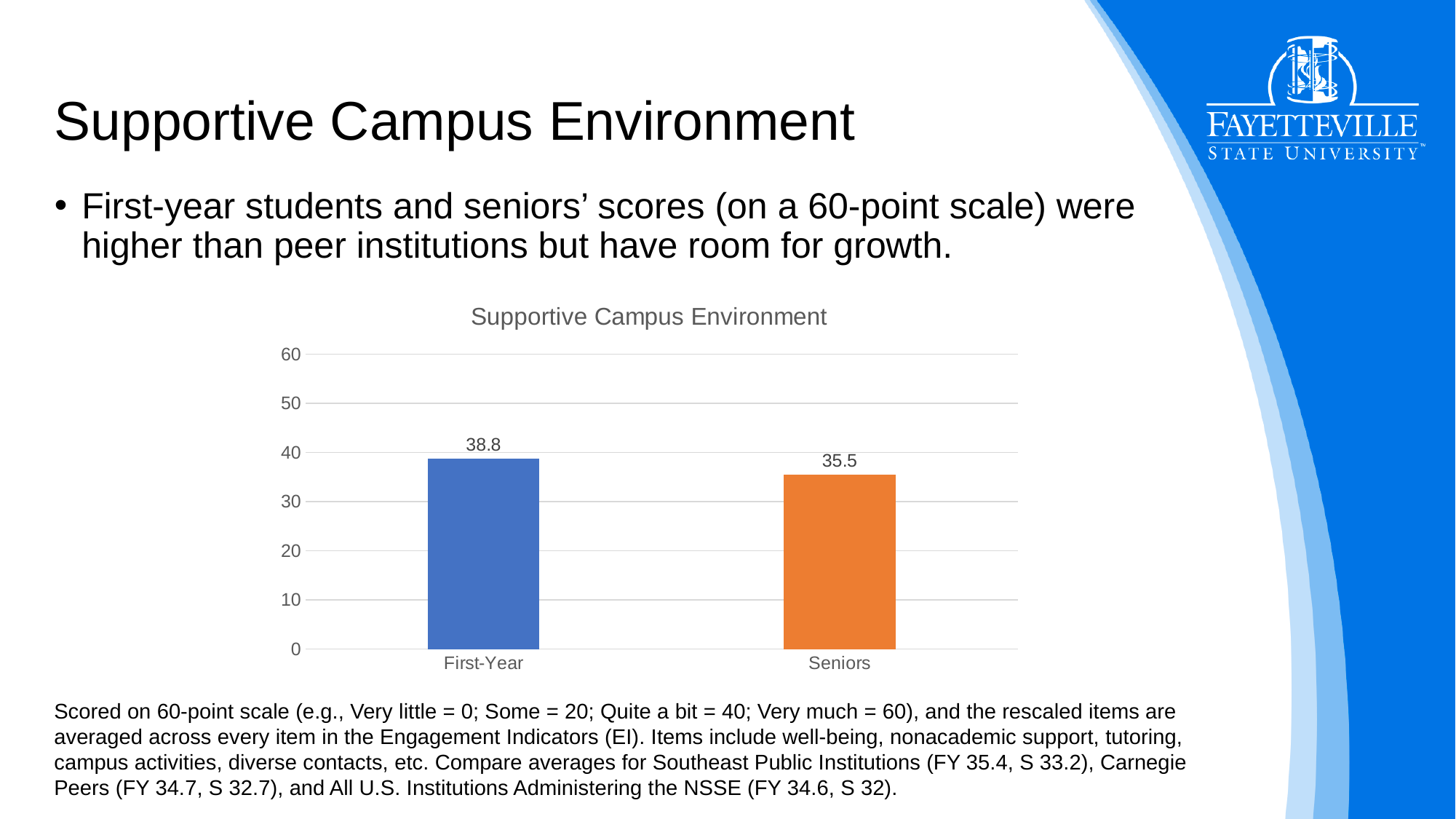
Which category has the lowest value in the chart? Seniors What is the difference between the First-Year and Seniors values? 3.3 Which category has the highest value in the chart? First-Year Is the value for Seniors greater or less than 40? less What kind of chart is shown on the slide? bar chart What is the value for Seniors in the Supportive Campus Environment chart? 35.5 What is the maximum value shown on the chart's vertical axis? 60 What is the title of the chart? Supportive Campus Environment What is the value for First-Year in the Supportive Campus Environment chart? 38.8 Is the value for First-Year greater or less than 30? greater How many categories are shown in the chart? 2 Which is larger, the value for First-Year or the value for Seniors? First-Year